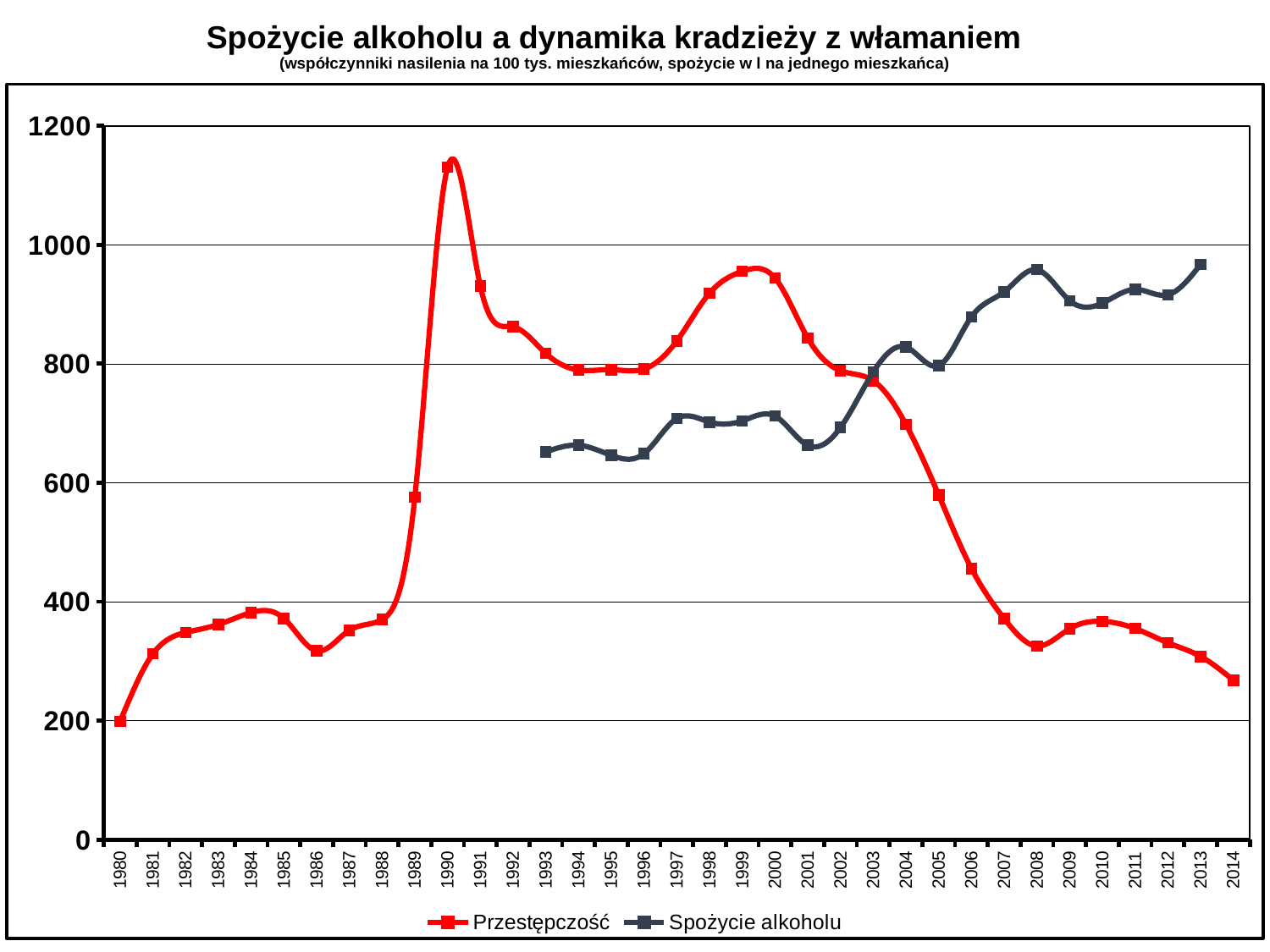
Is the value of Spożycie alkoholu in 1993 greater or less than 600? greater In which year does the Przestępczość series have its lowest value? 1980 In 2008, which series has the larger value, Przestępczość or Spożycie alkoholu? Spożycie alkoholu Is the value of Przestępczość in 1990 greater or less than 1000? greater What is the title of the chart? Spożycie alkoholu a dynamika kradzieży z włamaniem Is the value of Przestępczość in 2014 greater or less than 400? less How many series does the legend list? 2 What kind of chart is shown on the slide? line chart Does the Przestępczość series rise or fall between 2000 and 2008? fall How many years are shown on the x axis? 35 In which year does the Przestępczość series reach its highest value? 1990